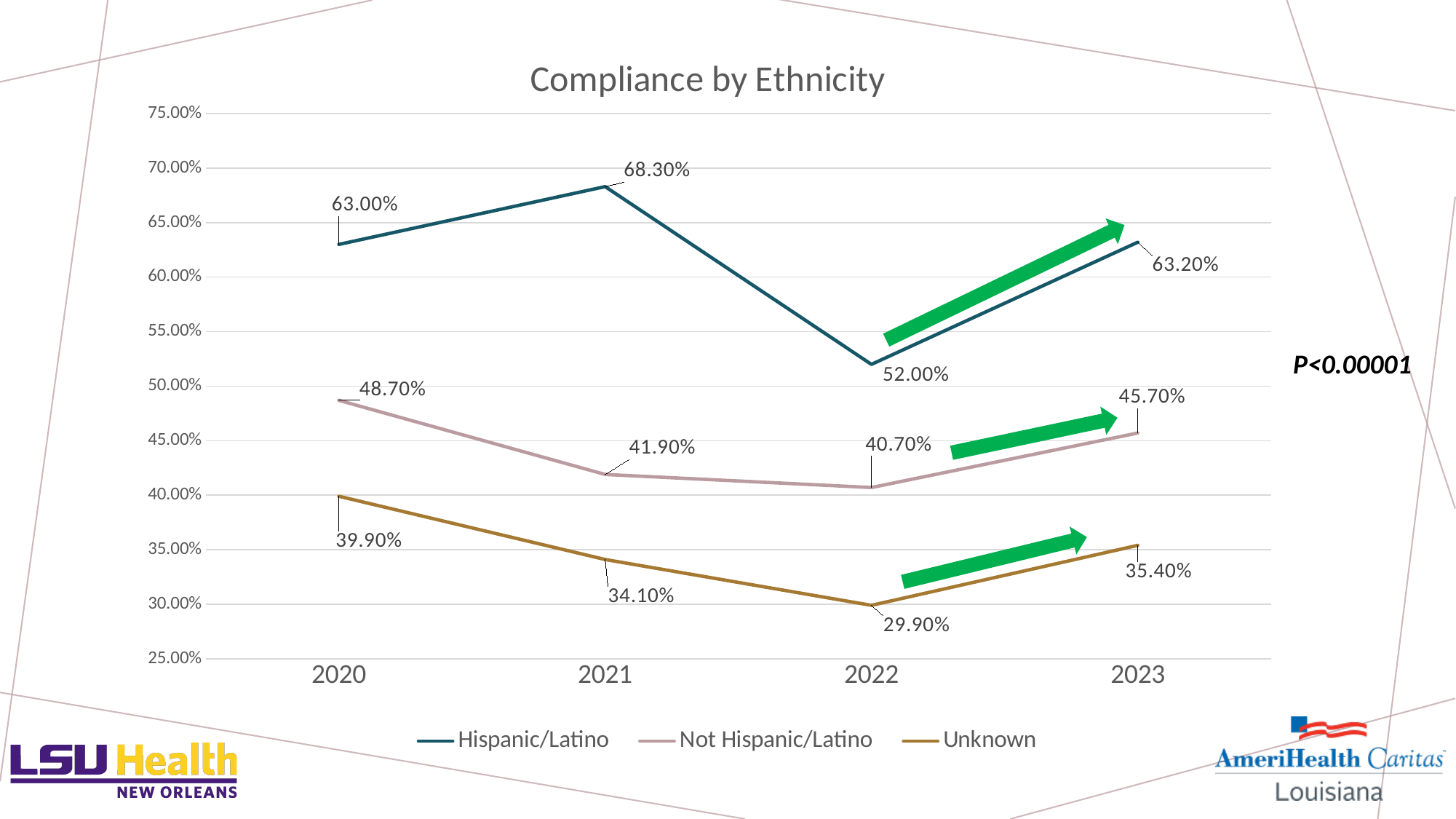
What kind of chart is shown on the slide? Line chart What is the compliance value for Hispanic/Latino in 2021? 68.30% What is the title of the chart? Compliance by Ethnicity How many years are shown on the x axis? 4 How many series does the legend list? 3 What is the difference between the Hispanic/Latino values in 2021 and 2022? 16.30% What is the compliance value for Not Hispanic/Latino in 2022? 40.70% What is the compliance value for Unknown in 2020? 39.90% In which year is the Hispanic/Latino compliance value lowest? 2022 In which year is the Unknown compliance value highest? 2020 Which is larger in 2023: the Not Hispanic/Latino value or the Unknown value? Not Hispanic/Latino What is the difference between the Not Hispanic/Latino values in 2023 and 2022? 5.00%